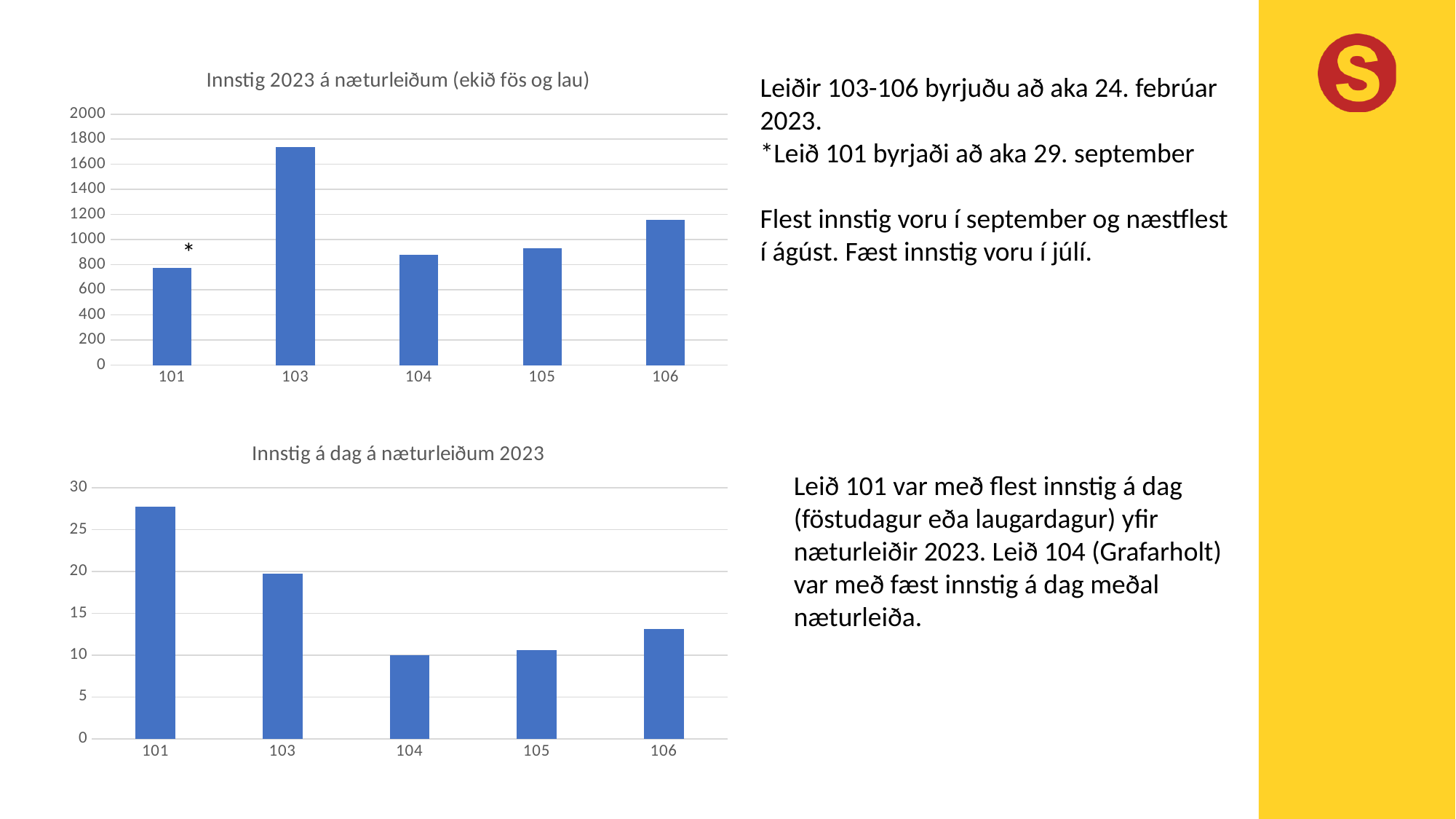
In the bottom chart 'Innstig á dag á næturleiðum 2023', which route has the highest boardings per day? 101 What is the title of the bottom chart on the slide? Innstig á dag á næturleiðum 2023 In the bottom chart 'Innstig á dag á næturleiðum 2023', which route has more boardings per day, 103 or 106? 103 In the top chart 'Innstig 2023 á næturleiðum (ekið fös og lau)', which route has the highest number of boardings? 103 In the bottom chart 'Innstig á dag á næturleiðum 2023', is the value for route 106 greater or less than 15? less In the bottom chart 'Innstig á dag á næturleiðum 2023', is the value for route 101 greater or less than 25? greater In the top chart 'Innstig 2023 á næturleiðum (ekið fös og lau)', which route has the lowest number of boardings? 101 In the top chart 'Innstig 2023 á næturleiðum (ekið fös og lau)', which route has more boardings, 106 or 105? 106 What type of chart is the top chart 'Innstig 2023 á næturleiðum (ekið fös og lau)'? bar chart How many routes are shown in the top chart 'Innstig 2023 á næturleiðum (ekið fös og lau)'? 5 In the top chart 'Innstig 2023 á næturleiðum (ekið fös og lau)', is the value for route 103 greater or less than 1600? greater